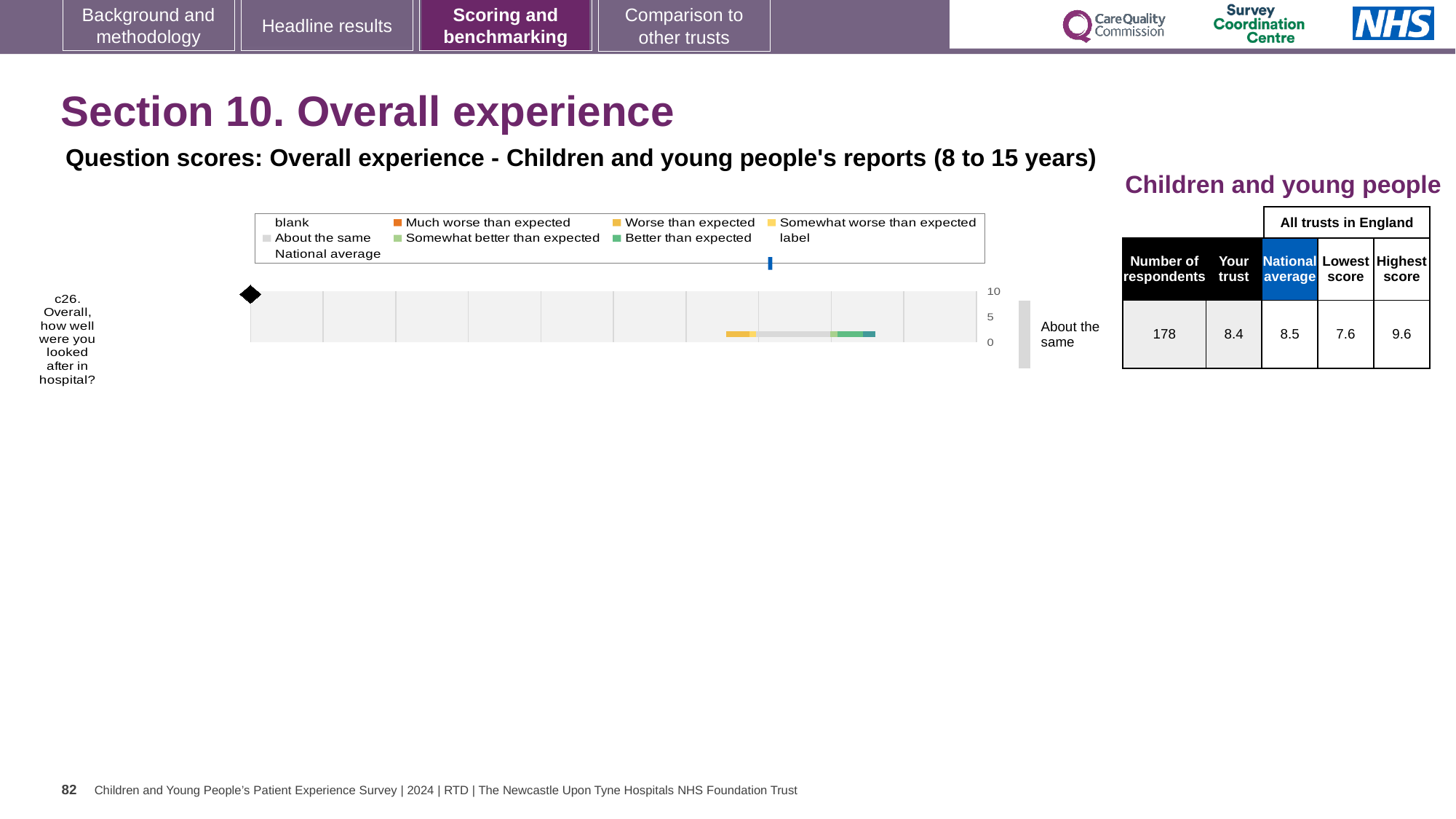
How many respondents answered question c26? 178 What is the difference between the highest score and the lowest score for question c26? 2.0 What is the highest score among all trusts in England for question c26? 9.6 What kind of chart is used to show the question score for c26? Bar chart What benchmark category is the trust's result for question c26 placed in? About the same Which is higher for question c26: the trust's score or the national average? National average What is the national average score for question c26? 8.5 How many survey questions are plotted on the chart? 1 What is the lowest score among all trusts in England for question c26? 7.6 What is the 'Your trust' score for question c26 'Overall, how well were you looked after in hospital?'? 8.4 By how much does the national average exceed the trust's score for question c26? 0.1 What is the subtitle describing the question scores shown on the slide? Question scores: Overall experience - Children and young people's reports (8 to 15 years)